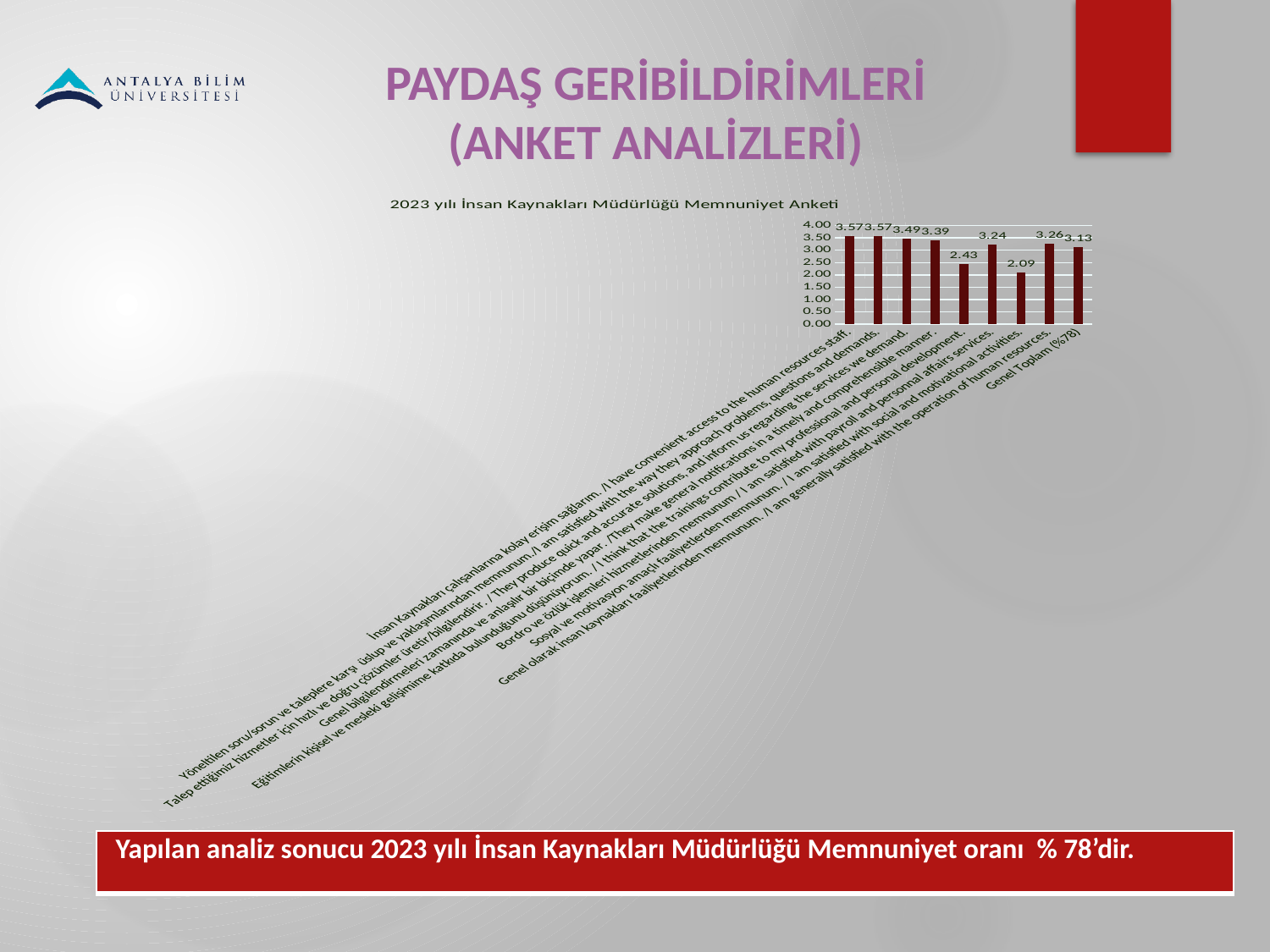
What is the maximum value shown on the vertical axis of the chart? 4.00 What is the title of the chart on the slide? 2023 yılı İnsan Kaynakları Müdürlüğü Memnuniyet Anketi How many bars does the chart contain? 9 What is the value for the category 'I am satisfied with social and motivational activities'? 2.09 Which category has the lowest value in the chart? I am satisfied with social and motivational activities (Sosyal ve motivasyon amaçlı faaliyetlerden memnunum) What is the value for the category 'I think that the trainings contribute to my professional and personal development'? 2.43 What is the value for the 'Genel Toplam (%78)' bar? 3.13 What is the difference between the highest value (3.57) and the lowest value (2.09) in the chart? 1.48 What is the value for the category 'I am satisfied with payroll and personal affairs services'? 3.24 Which is larger: the value for the trainings category or the value for the social and motivational activities category? the trainings category (2.43) What kind of chart is shown on the slide? bar chart Is the value for the trainings category greater or less than 3.00? less